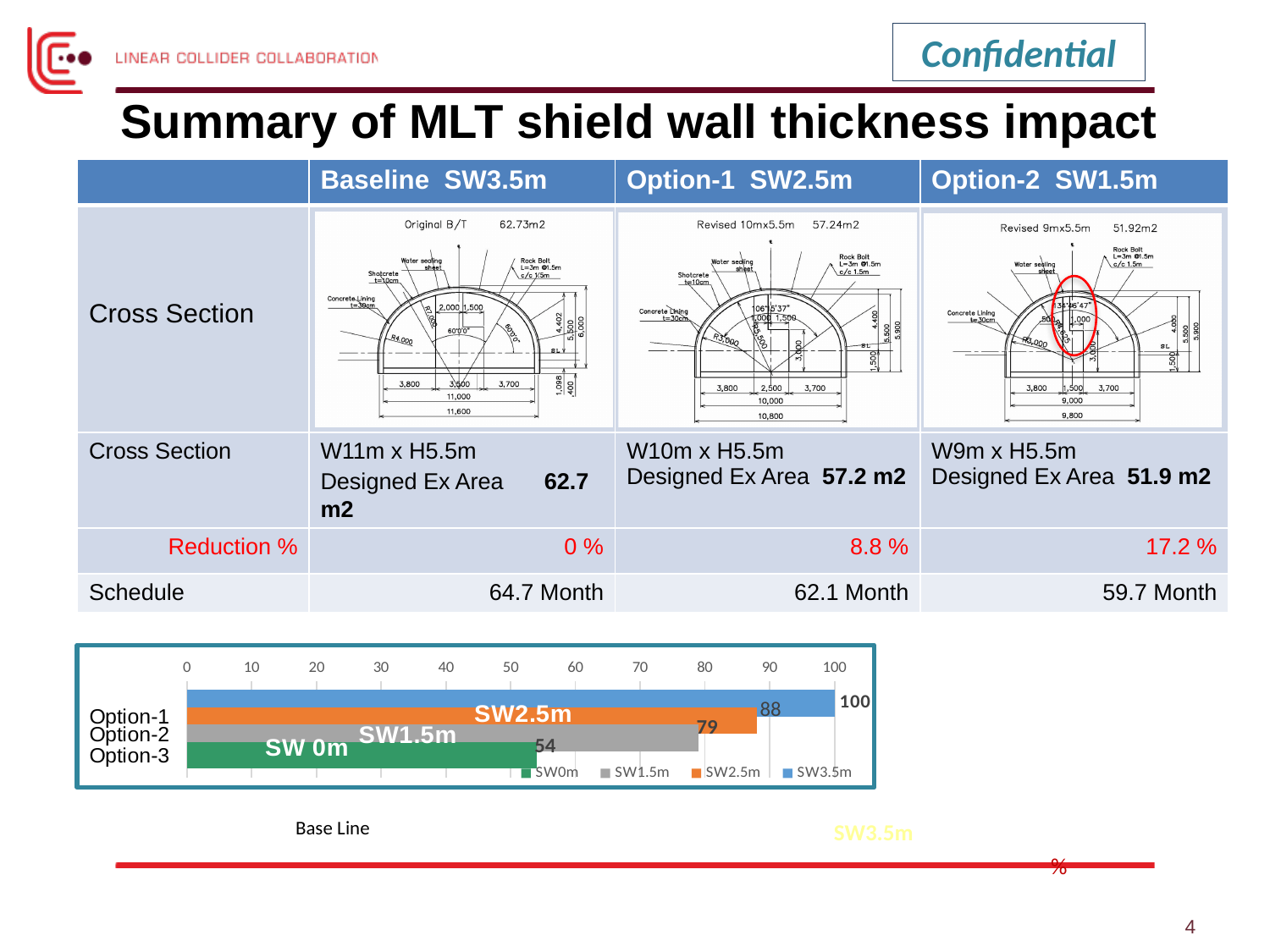
In the bar chart, which is larger, the SW2.5m value or the SW1.5m value? SW2.5m How many series does the legend of the bar chart list? 4 What type of chart is shown at the bottom of the slide? bar chart In the bar chart, what is the value of the SW0m bar? 54 In the bar chart, what is the difference between the SW2.5m value and the SW1.5m value? 9 In the bar chart, what is the difference between the SW3.5m value and the SW0m value? 46 In the bar chart, which series has the highest value? SW3.5m In the bar chart, what is the value of the SW1.5m bar? 79 In the bar chart, which series has the lowest value? SW0m In the bar chart, what is the value of the SW2.5m bar? 88 In the bar chart, what is the value of the SW3.5m bar? 100 In the bar chart, what colour is the SW3.5m bar? blue